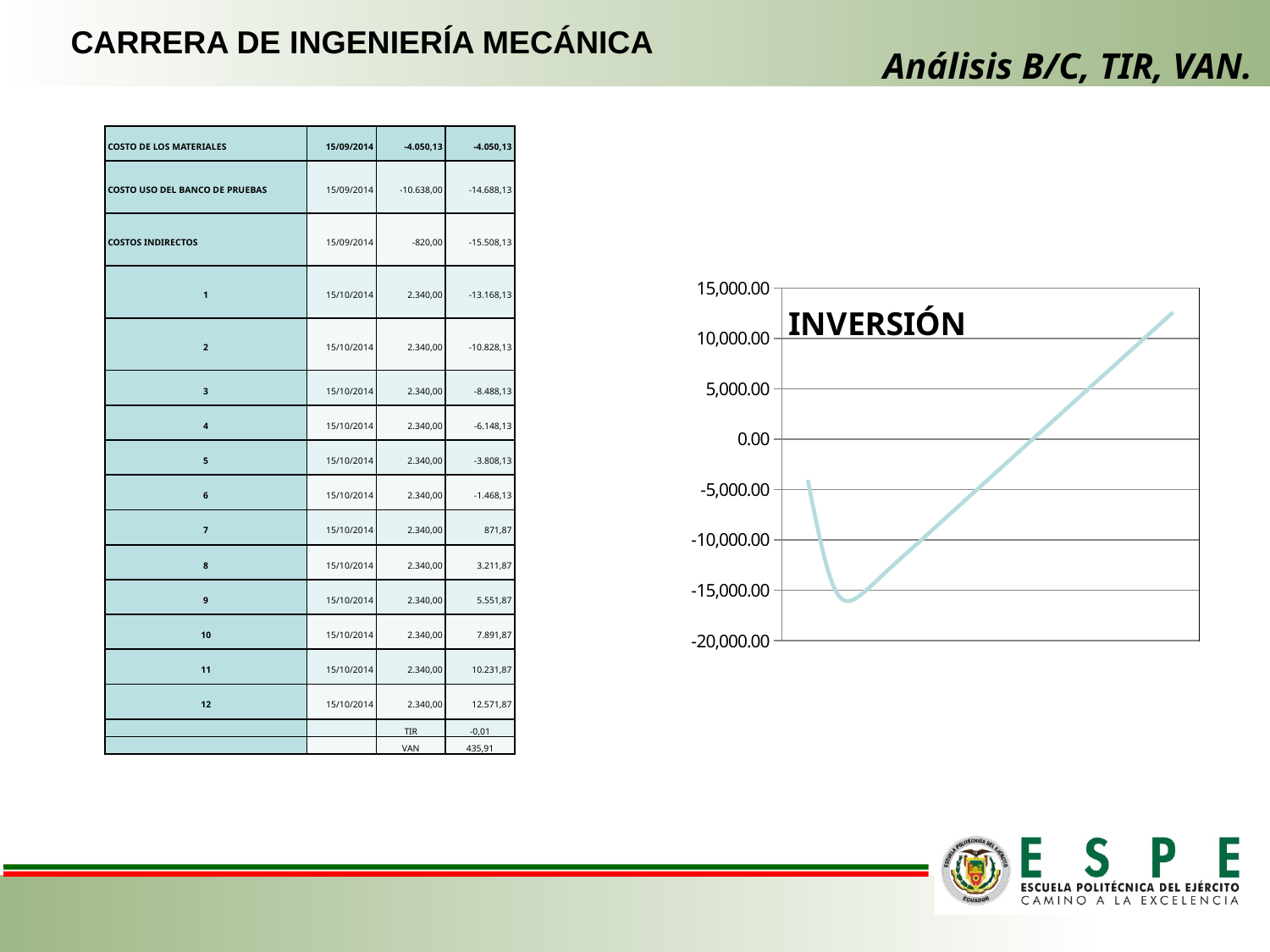
Does the line in the INVERSIÓN chart end above or below 0.00? above Is the value at the left end of the line in the INVERSIÓN chart greater or less than -10,000.00? greater After reaching its lowest point, does the line in the INVERSIÓN chart rise or fall toward the right? rise Is the value at the right end of the line in the INVERSIÓN chart greater or less than 10,000.00? greater Which is larger in the INVERSIÓN chart: the value at the left end of the line or the value at the right end? the right end What is the highest value shown on the chart's y axis? 15,000.00 What is the title of the chart? INVERSIÓN At the start of the INVERSIÓN chart, does the line initially rise or fall? fall What kind of chart is shown on the slide? line chart